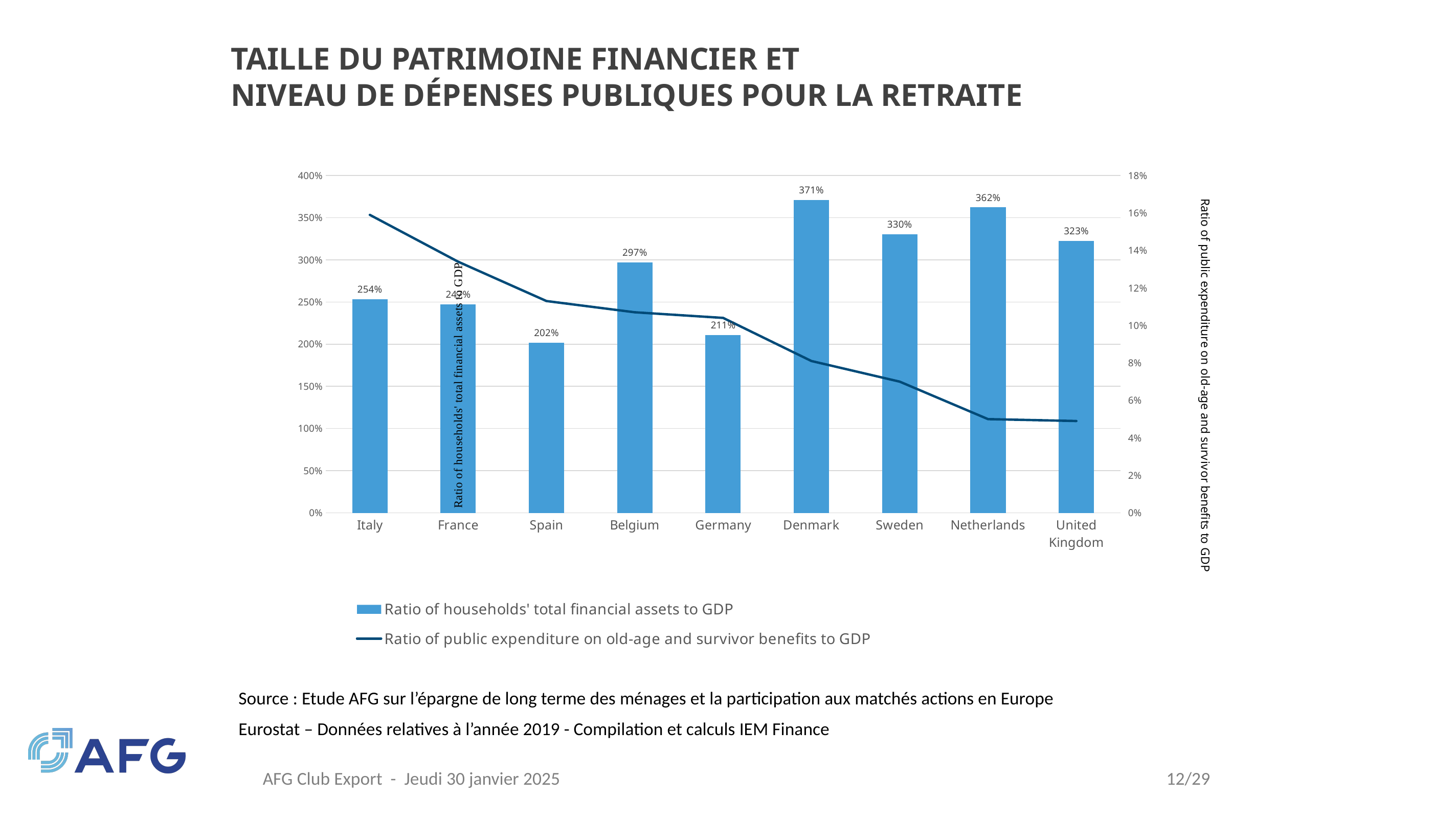
Which country has the lowest ratio of households' total financial assets to GDP? Spain Which country has the highest ratio of households' total financial assets to GDP? Denmark What is the ratio of households' total financial assets to GDP for the United Kingdom? 323% Does the line for the ratio of public expenditure on old-age and survivor benefits to GDP rise or fall from Italy to the United Kingdom? fall Is the ratio of public expenditure on old-age and survivor benefits to GDP for Italy greater or less than 14%? greater How many series does the legend list? 2 What is the ratio of households' total financial assets to GDP for Spain? 202% What is the ratio of households' total financial assets to GDP for Denmark? 371% What is the difference between Denmark's and Netherlands' ratio of households' total financial assets to GDP? 9 percentage points What kind of chart is shown on the slide? Bar chart combined with a line chart How many countries are shown on the x axis of the chart? 9 Which has a higher ratio of households' total financial assets to GDP, Sweden or the United Kingdom? Sweden